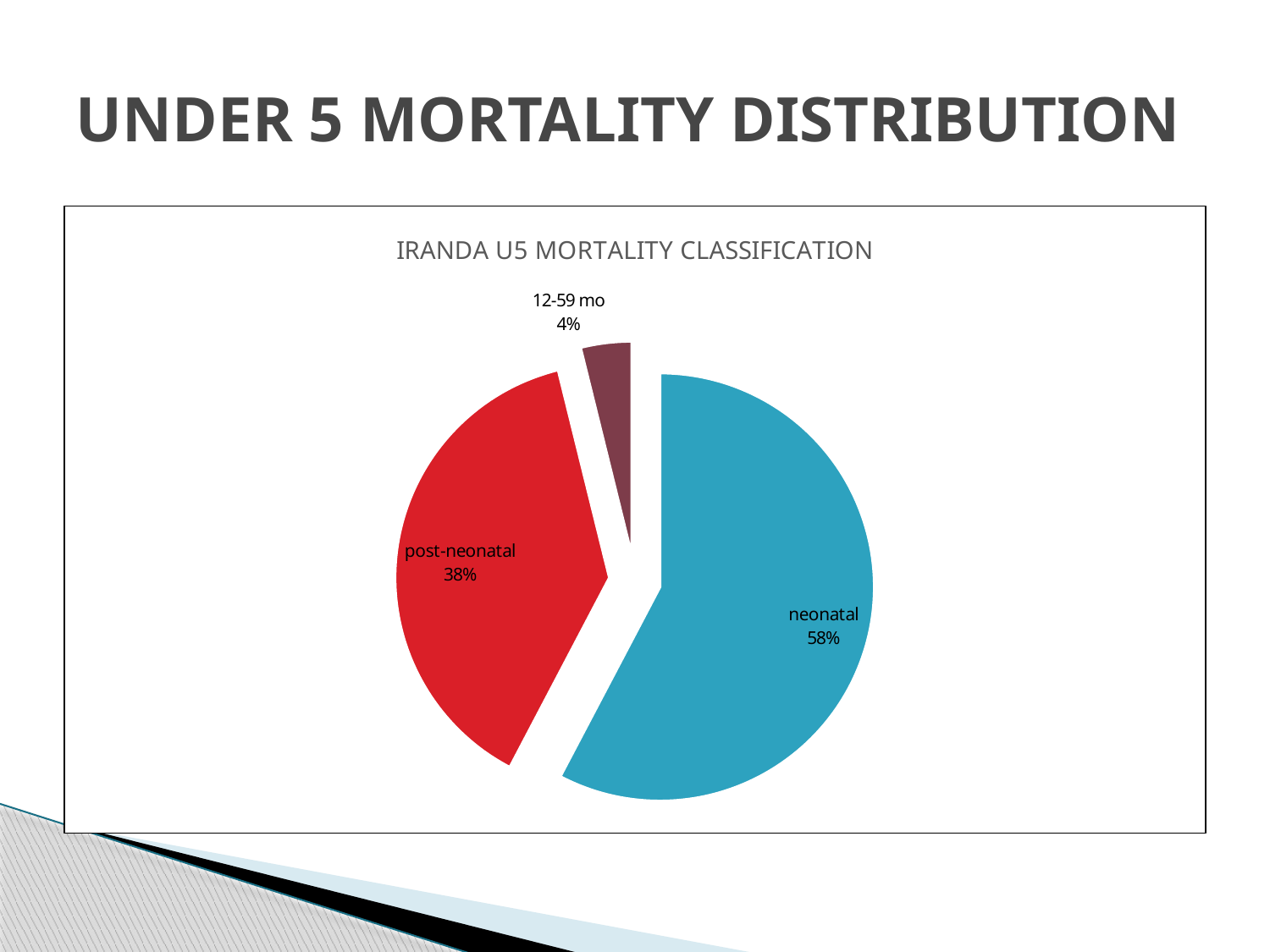
What kind of chart is shown on the slide? pie chart Which category has the largest share of the pie? neonatal What share of the pie does the post-neonatal slice represent? 38% What is the title of the chart? IRANDA U5 MORTALITY CLASSIFICATION How many slices does the pie chart have? 3 Which is larger, the post-neonatal share or the 12-59 mo share? post-neonatal What colour is the neonatal slice? blue Which category has the smallest share of the pie? 12-59 mo What share of the pie does the neonatal slice represent? 58% What share of the pie does the 12-59 mo slice represent? 4% What is the difference in percentage points between the post-neonatal and 12-59 mo shares? 34 What is the difference in percentage points between the neonatal and post-neonatal shares? 20